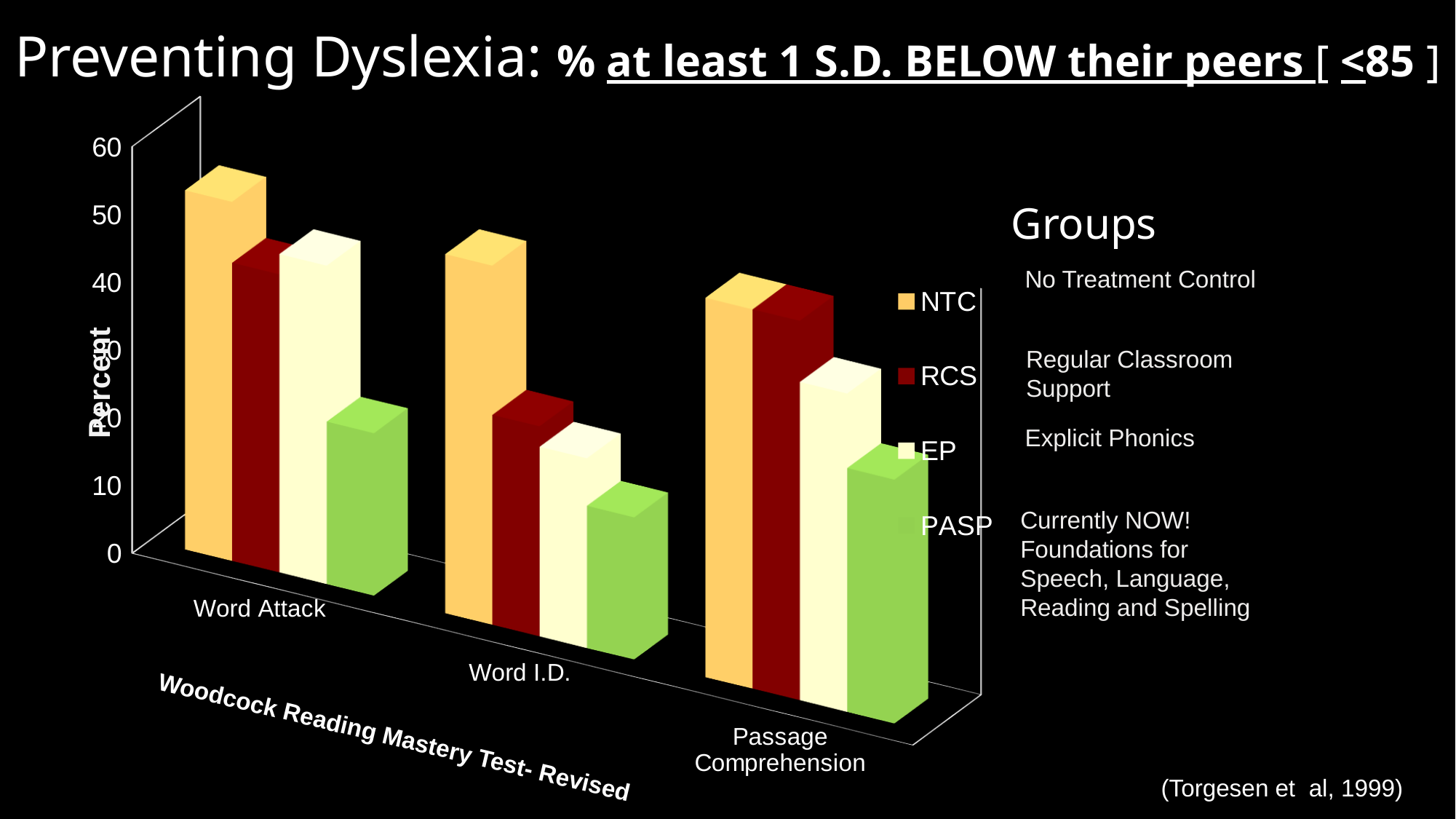
For Word I.D., which group has the highest percentage? NTC What kind of chart is shown on the slide? bar chart For Passage Comprehension, which group has the lowest percentage? PASP Is the value for PASP in Word Attack greater or less than 40? less Is the value for NTC in Word I.D. greater or less than 40? greater For Word Attack, which group has the lowest percentage? PASP For Passage Comprehension, is the value for EP or PASP larger? EP What is the title of the vertical axis? Percent For Word Attack, which group has the highest percentage? NTC For Word I.D., is the value for RCS or EP larger? RCS How many test categories are shown along the x axis? 3 How many groups does the legend list? 4